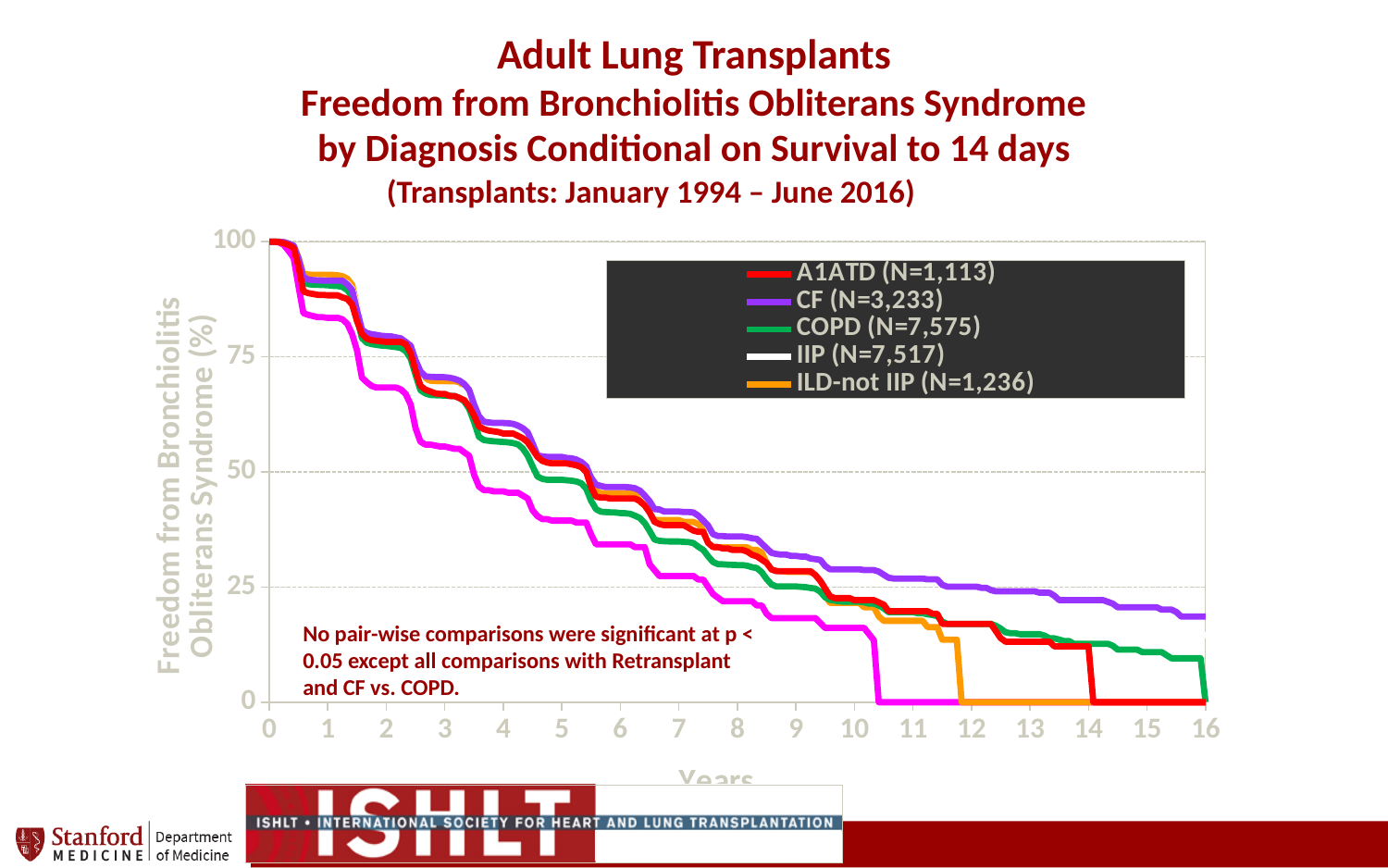
What is the label of the y axis? Freedom from Bronchiolitis Obliterans Syndrome (%) At 16 years, which is higher, the CF curve or the COPD curve? CF What is the N for the COPD series shown in the legend? 7,575 How many series does the legend list? 5 Is the value for CF at 16 years greater or less than 25? less What is the N for the CF series shown in the legend? 3,233 Which series in the legend has the largest N? COPD (N=7,575) What kind of chart is shown on the slide? line chart Which series in the legend has the smallest N? A1ATD (N=1,113) Do the curves rise or fall as years increase along the x axis? fall What is the transplant date range given in the chart title? January 1994 – June 2016 What is the difference between the N for COPD and the N for IIP? 58